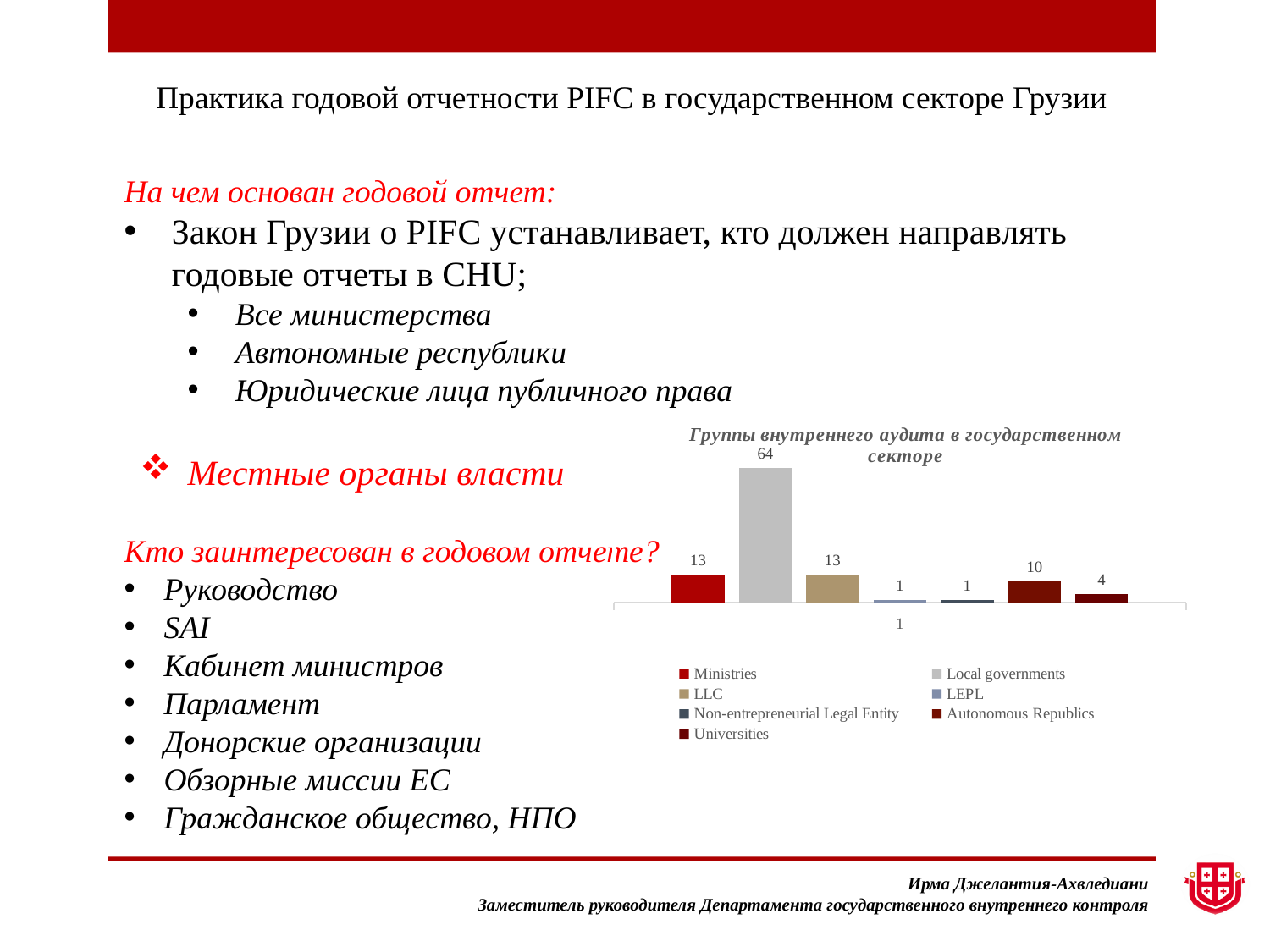
How many series does the legend list? 7 What is the title of the chart? Группы внутреннего аудита в государственном секторе Which is larger, the value for LLC or the value for Autonomous Republics? LLC What is the value for Local governments in the chart? 64 What is the difference between the values for Local governments and Ministries? 51 What kind of chart is shown on the slide? Bar chart Which series has the highest value in the chart? Local governments What is the value for Ministries in the chart? 13 What is the value for Universities in the chart? 4 What is the value for LEPL in the chart? 1 What is the difference between the values for Autonomous Republics and Universities? 6 What is the value for Autonomous Republics in the chart? 10